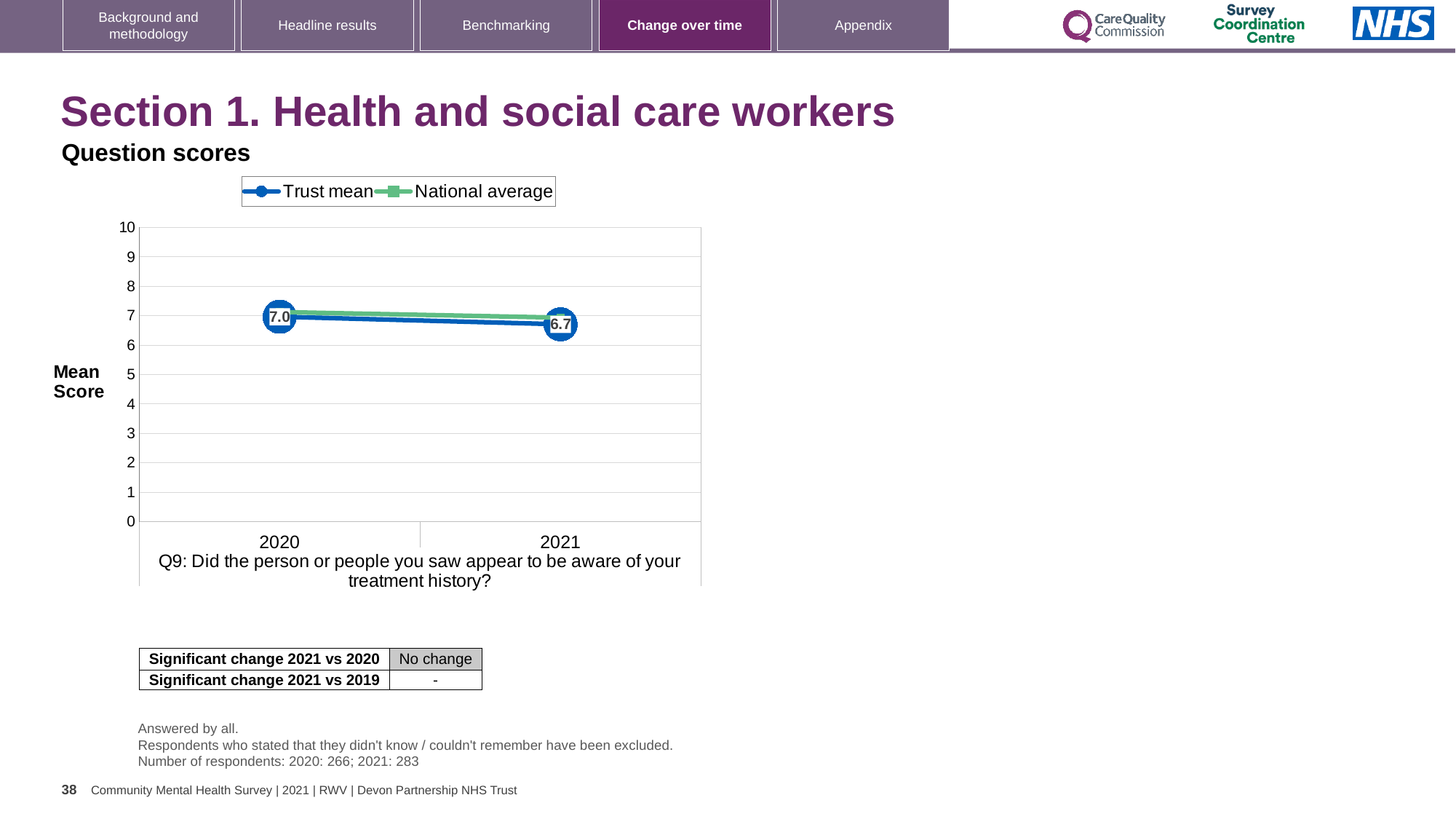
What are the two series named in the legend? Trust mean and National average How many years are plotted on the x axis? 2 What is the Trust mean score for 2021? 6.7 Does the Trust mean rise or fall from 2020 to 2021? fall What is the label on the y axis of the chart? Mean Score Is the National average value for 2021 greater or less than 6? greater Is the National average value for 2020 greater or less than 8? less What kind of chart is shown on the slide? line chart What is the Trust mean score for 2020? 7.0 How many series does the legend list? 2 By how much did the Trust mean score change between 2020 and 2021? 0.3 Which year has the higher Trust mean score, 2020 or 2021? 2020